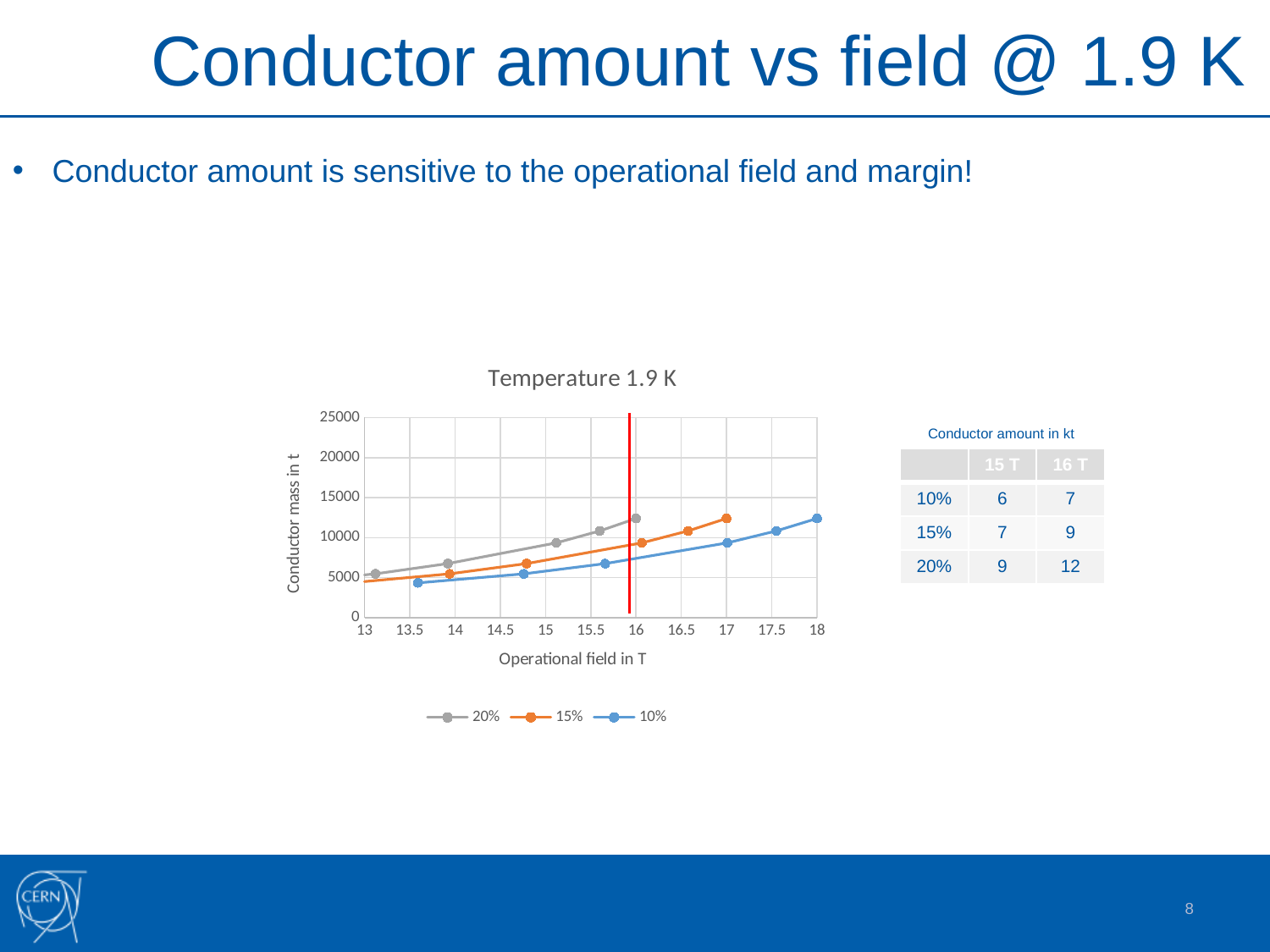
At 16 T, which series has the highest conductor mass? 20% Is the value for the 10% series at 16 T greater or less than 10000? less Does the conductor mass rise or fall as the operational field increases for the 10% series? rise What kind of chart is shown on the slide? line chart Is the value for the 15% series at 17 T greater or less than 10000? greater At 16 T, which series has the higher conductor mass, 15% or 10%? 15% At 16 T, which series has the higher conductor mass, 20% or 10%? 20% How many series does the chart legend list? 3 What is the title of the chart? Temperature 1.9 K Is the value for the 20% series at 16 T greater or less than 10000? greater What is the label of the chart's x axis? Operational field in T